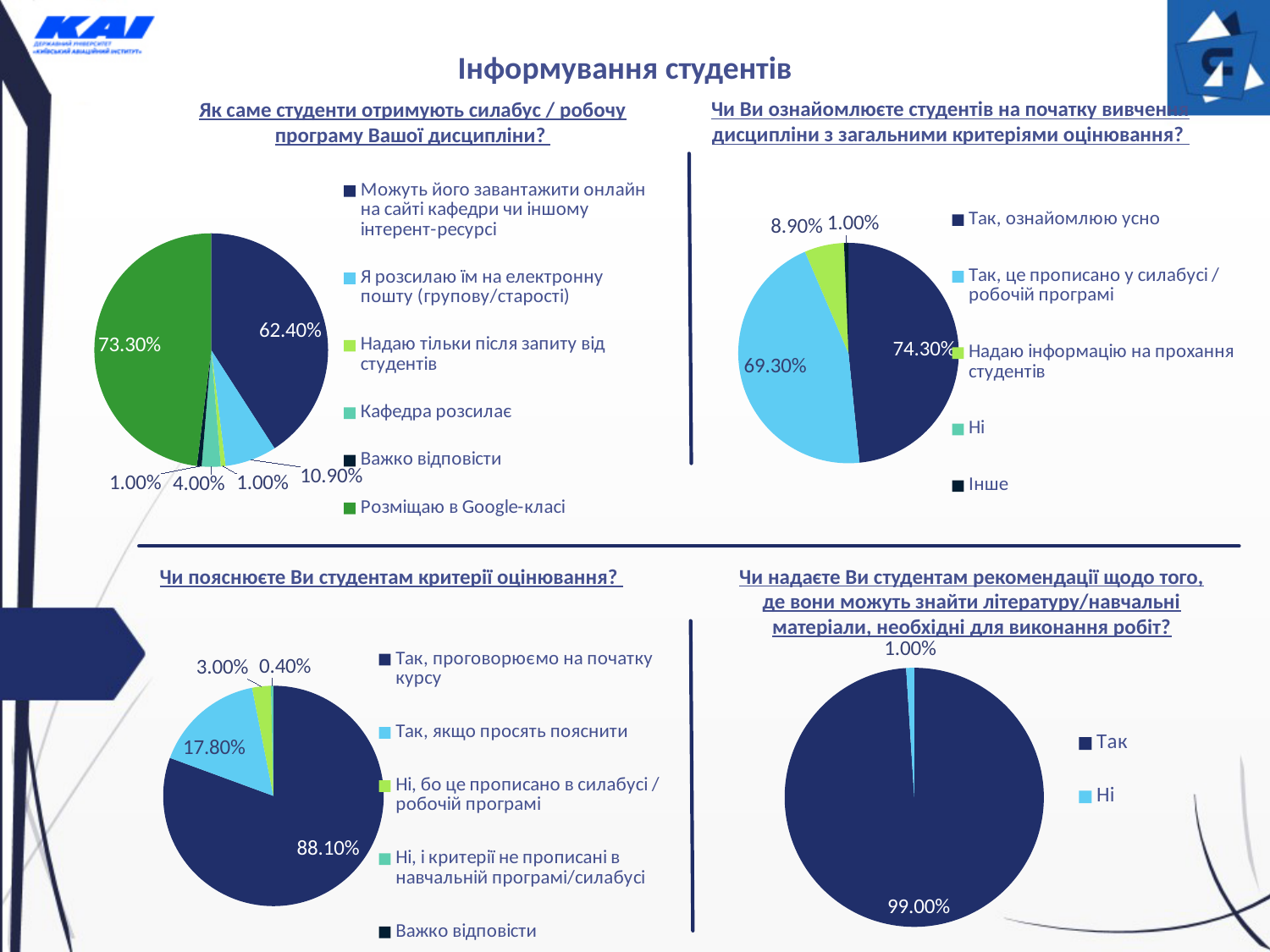
In the chart 'Як саме студенти отримують силабус / робочу програму Вашої дисципліни?', what percentage is shown for 'Розміщаю в Google-класі'? 73.30% In the bottom-right chart about recommendations on where to find literature/study materials, what percentage answered 'Ні'? 1.00% In the chart 'Чи пояснюєте Ви студентам критерії оцінювання?', what percentage is shown for 'Так, проговорюємо на початку курсу'? 88.10% In the bottom-right chart about recommendations on where to find literature/study materials, what percentage answered 'Так'? 99.00% In the chart 'Як саме студенти отримують силабус / робочу програму Вашої дисципліни?', what percentage is shown for 'Можуть його завантажити онлайн на сайті кафедри чи іншому інтерент-ресурсі'? 62.40% In the chart 'Чи Ви ознайомлюєте студентів на початку вивчення дисципліни з загальними критеріями оцінювання?', what percentage is shown for 'Надаю інформацію на прохання студентів'? 8.90% In the chart 'Як саме студенти отримують силабус / робочу програму Вашої дисципліни?', what percentage is shown for 'Я розсилаю їм на електронну пошту (групову/старості)'? 10.90% How many entries does the legend list in the chart 'Як саме студенти отримують силабус / робочу програму Вашої дисципліни?'? 6 In the chart 'Чи пояснюєте Ви студентам критерії оцінювання?', which is larger: 'Так, якщо просять пояснити' or 'Ні, бо це прописано в силабусі / робочій програмі'? Так, якщо просять пояснити In the chart 'Чи Ви ознайомлюєте студентів на початку вивчення дисципліни з загальними критеріями оцінювання?', what is the difference between 'Так, ознайомлюю усно' and 'Так, це прописано у силабусі / робочій програмі'? 5.00% In the chart 'Чи Ви ознайомлюєте студентів на початку вивчення дисципліни з загальними критеріями оцінювання?', what percentage is shown for 'Так, ознайомлюю усно'? 74.30% What type of chart is used in the bottom-right chart about recommendations on where to find literature/study materials? Pie chart